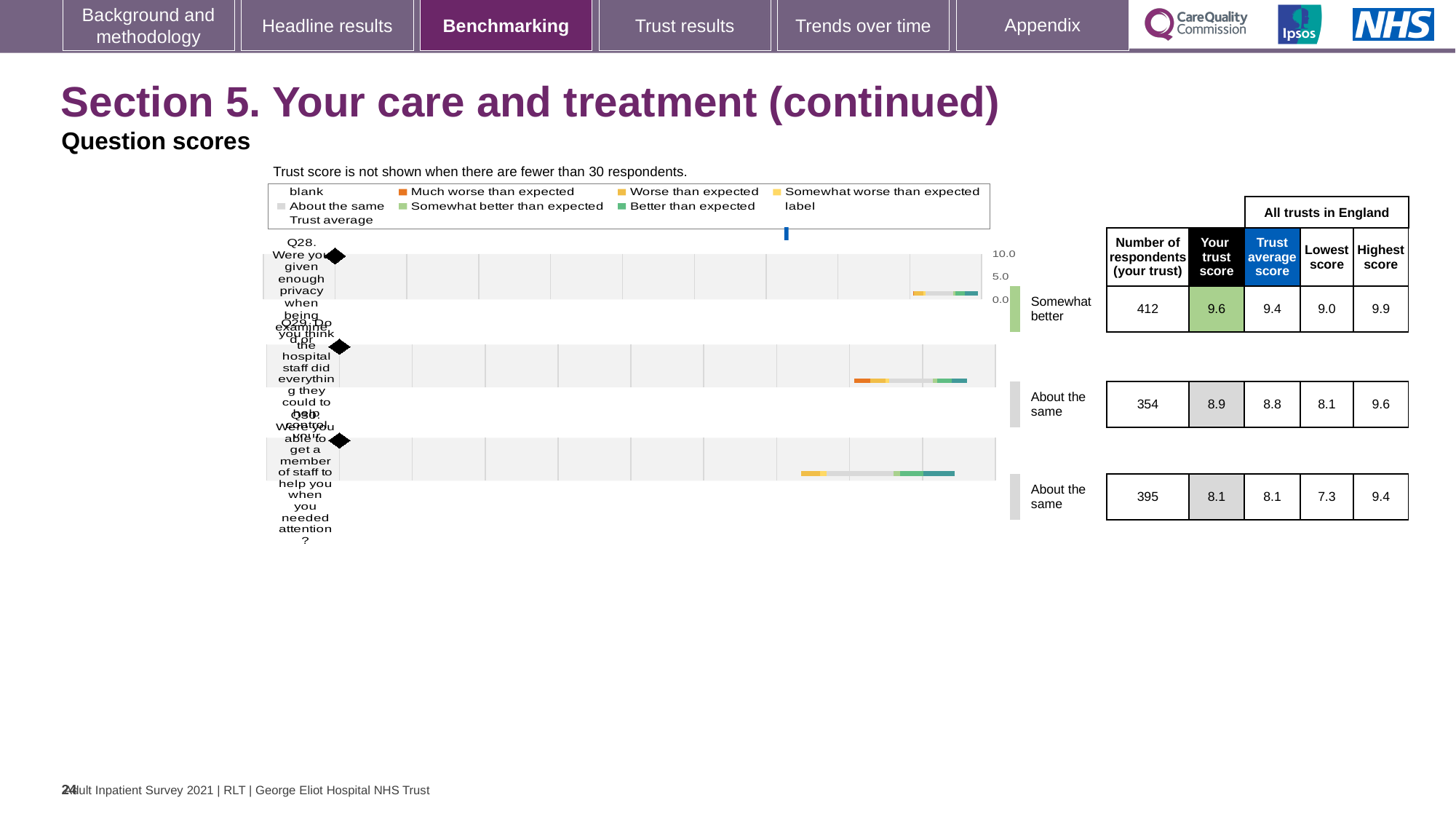
What kind of chart is used to show the question scores on this slide? bar chart What is the trust score for Q29 (Do you think the hospital staff did everything they could to help control your pain)? 8.9 Which has the larger trust score, Q29 or Q30? Q29 What is the trust score for Q28 (Were you given enough privacy when being examined or treated)? 9.6 What is the highest value shown on the score axis of the charts? 10.0 Which question has the lowest trust score? Q30 What is the trust score for Q30 (Were you able to get a member of staff to help you when you needed attention)? 8.1 Which benchmark category is shown next to the Q28 chart? Somewhat better Which question has the highest trust score? Q28 How many questions (Q28, Q29, Q30) are plotted in the question score charts? 3 What is the difference between the trust scores for Q28 and Q30? 1.5